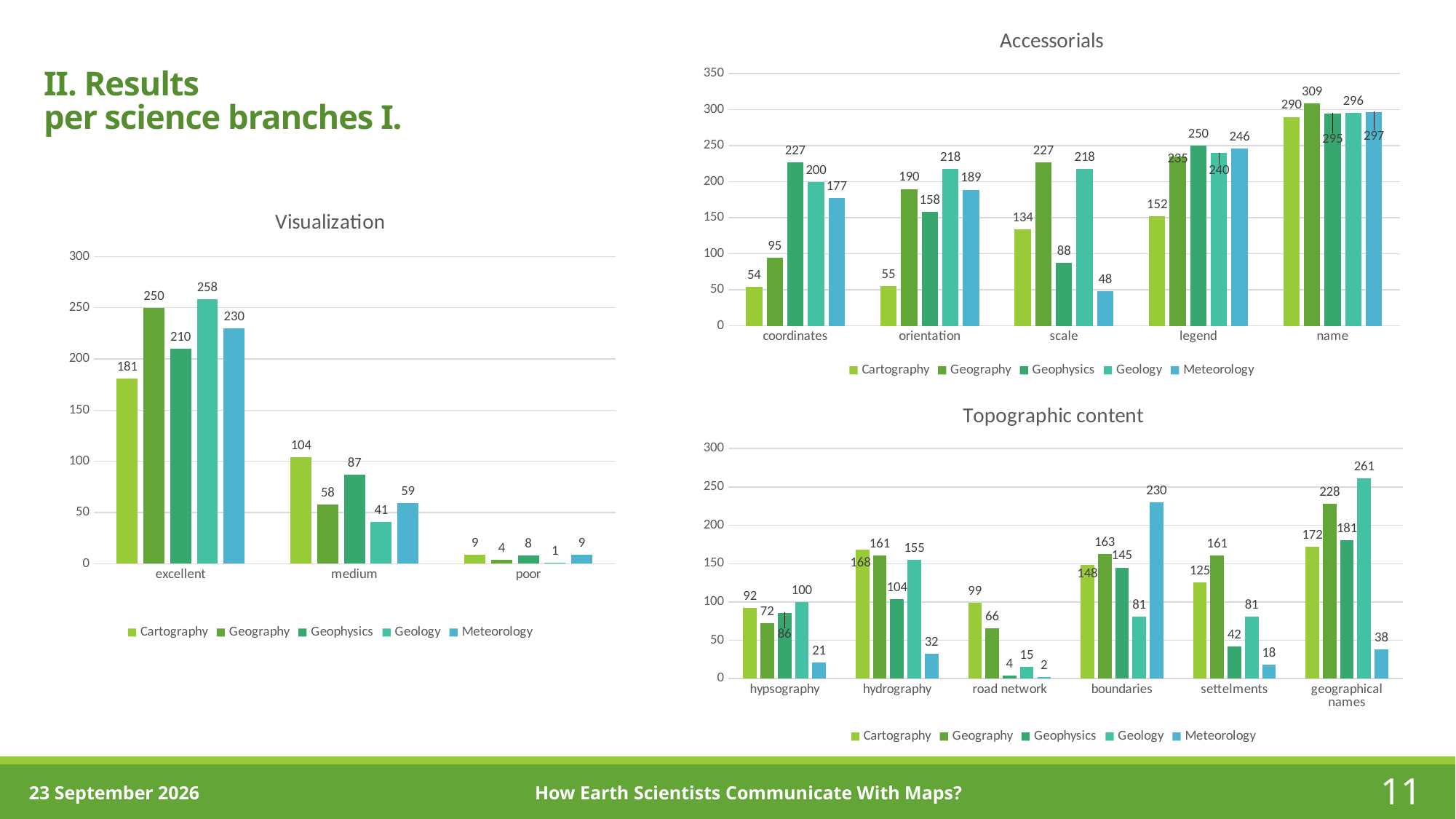
In the Visualization chart, what is the difference between Geography and Cartography in the excellent category? 69 In the Visualization chart, which series has the highest value in the medium category? Cartography In the Topographic content chart, what is the value for Meteorology in the boundaries category? 230 In the Visualization chart, what is the value for Geology in the excellent category? 258 In the Topographic content chart, what is the difference between Cartography and Geography in the settlements category? 36 In the Accessorials chart, how many series does the legend list? 5 In the Accessorials chart, which is larger in the orientation category: Geology or Geography? Geology In the Visualization chart, how many categories are shown on the x axis? 3 What kind of chart is the Topographic content chart? Bar chart In the Accessorials chart, what is the value for Geophysics in the coordinates category? 227 In the Accessorials chart, which series has the lowest value in the scale category? Meteorology In the Topographic content chart, which series has the highest value in the geographical names category? Geology